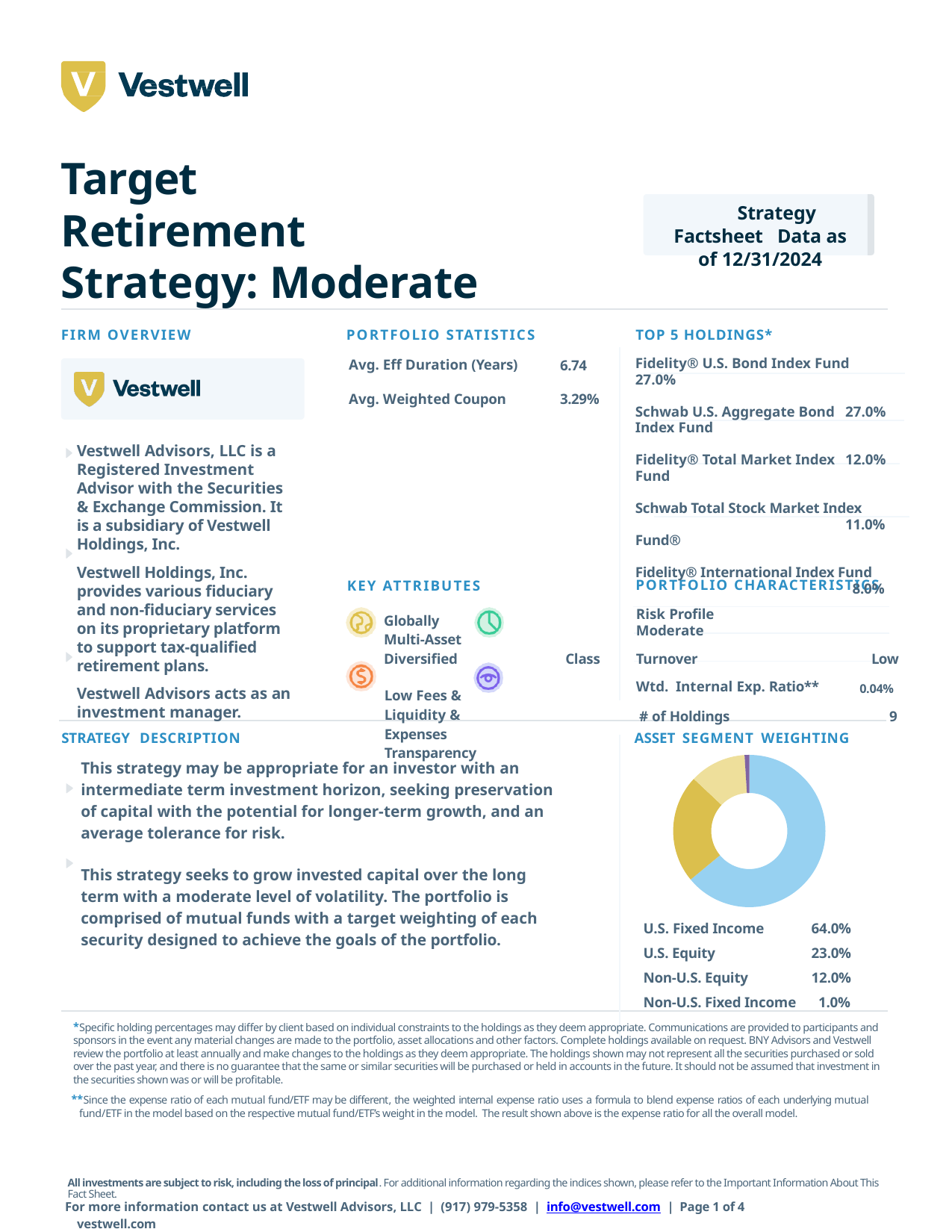
In the Asset Segment Weighting chart, what is the difference between the U.S. Fixed Income and U.S. Equity weightings? 41.0% In the Asset Segment Weighting chart, which asset segment has the smallest weighting? Non-U.S. Fixed Income In the Asset Segment Weighting chart, what is the weighting for Non-U.S. Equity? 12.0% In the Asset Segment Weighting chart, what is the weighting for U.S. Equity? 23.0% In the Asset Segment Weighting chart, what is the combined weighting of U.S. Equity and Non-U.S. Equity? 35.0% What is the title of the chart on the slide? Asset Segment Weighting In the Asset Segment Weighting chart, what is the weighting for U.S. Fixed Income? 64.0% What kind of chart is shown under Asset Segment Weighting? Donut (pie) chart In the Asset Segment Weighting chart, which asset segment has the largest weighting? U.S. Fixed Income In the Asset Segment Weighting chart, what is the weighting for Non-U.S. Fixed Income? 1.0% In the Asset Segment Weighting chart, which is larger: U.S. Equity or Non-U.S. Equity? U.S. Equity In the Asset Segment Weighting chart, how many asset segments are shown? 4